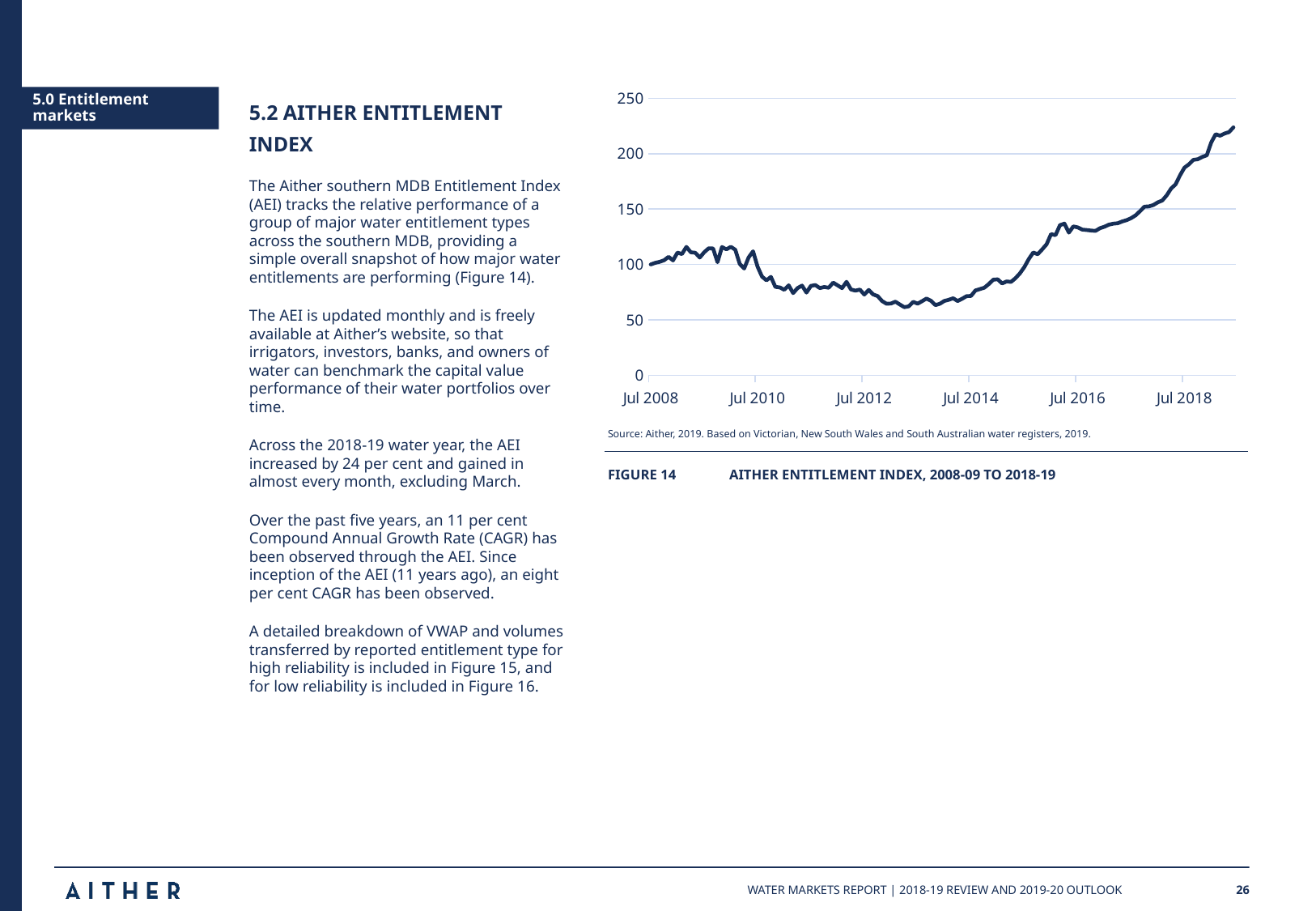
How many date labels are shown on the x axis? 6 Is the value of the index at Jul 2012 greater or less than 100? less Is the final value of the index at the right end of the line greater or less than 200? greater Is the value of the index at Jul 2018 greater or less than 150? greater Of the dates labelled on the x axis, at which is the index highest? Jul 2018 Does the index rise or fall overall between Jul 2012 and Jul 2018? rise Which is larger, the index value at Jul 2012 or at Jul 2018? Jul 2018 What is the title of Figure 14? Aither Entitlement Index, 2008-09 to 2018-19 What is the highest value labelled on the y axis? 250 What kind of chart is shown in Figure 14? line chart